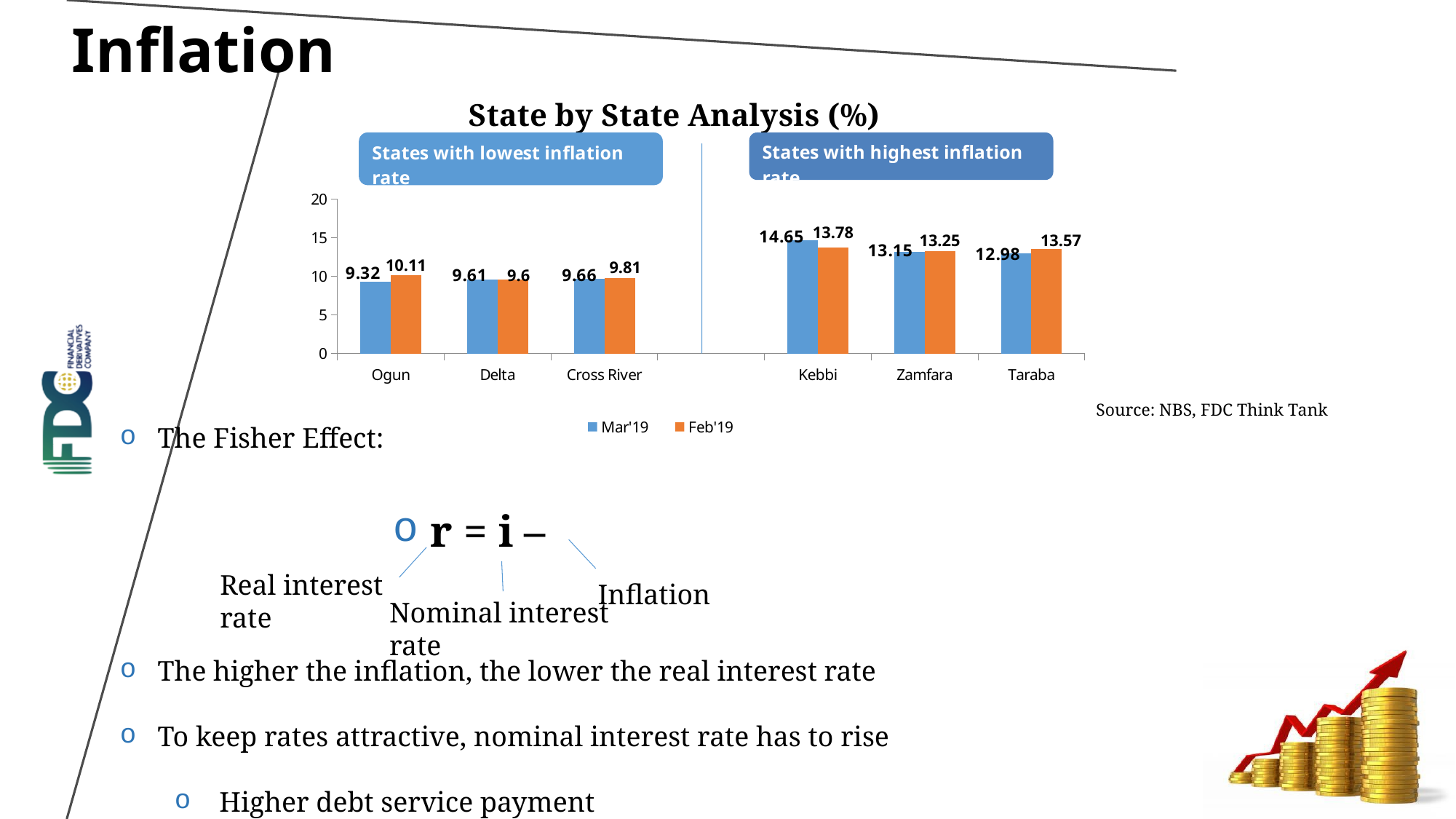
What is the Mar'19 inflation rate for Ogun? 9.32 How many states are shown on the chart? 6 What is the title of the chart? State by State Analysis (%) Which state has the lowest Mar'19 inflation rate? Ogun What is the Mar'19 value for Taraba? 12.98 What is the difference between the Feb'19 and Mar'19 values for Ogun? 0.79 How many series does the legend list? 2 What kind of chart is shown? bar chart Is the Mar'19 value for Cross River greater or less than 10? less Which is larger for Zamfara, the Mar'19 value or the Feb'19 value? Feb'19 Which state has the highest Mar'19 inflation rate? Kebbi What is the Feb'19 inflation rate for Kebbi? 13.78